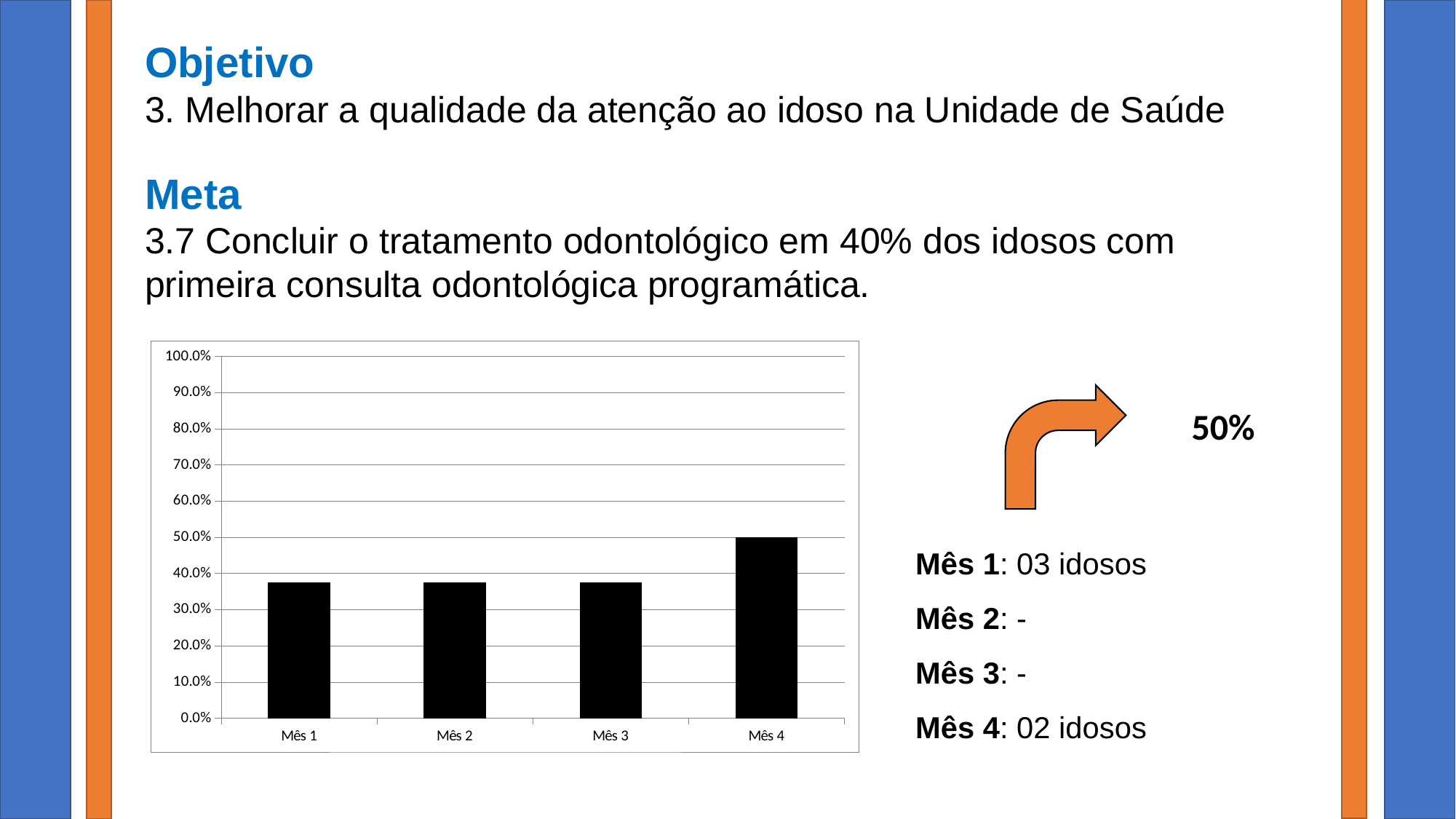
What is the value for Mês 4 on the chart? 50.0% What colour are the bars in the chart? black Is the value for Mês 4 greater or less than 40.0%? greater Is the value for Mês 1 greater or less than 40.0%? less Does the value rise or fall from Mês 3 to Mês 4? rise Which is larger, the value for Mês 1 or the value for Mês 4? Mês 4 What is the highest value shown on the chart's vertical axis? 100.0% Is the value for Mês 2 greater or less than 30.0%? greater What kind of chart is shown on the slide? bar chart Which month has the highest value on the chart? Mês 4 How many categories (months) are plotted on the chart? 4